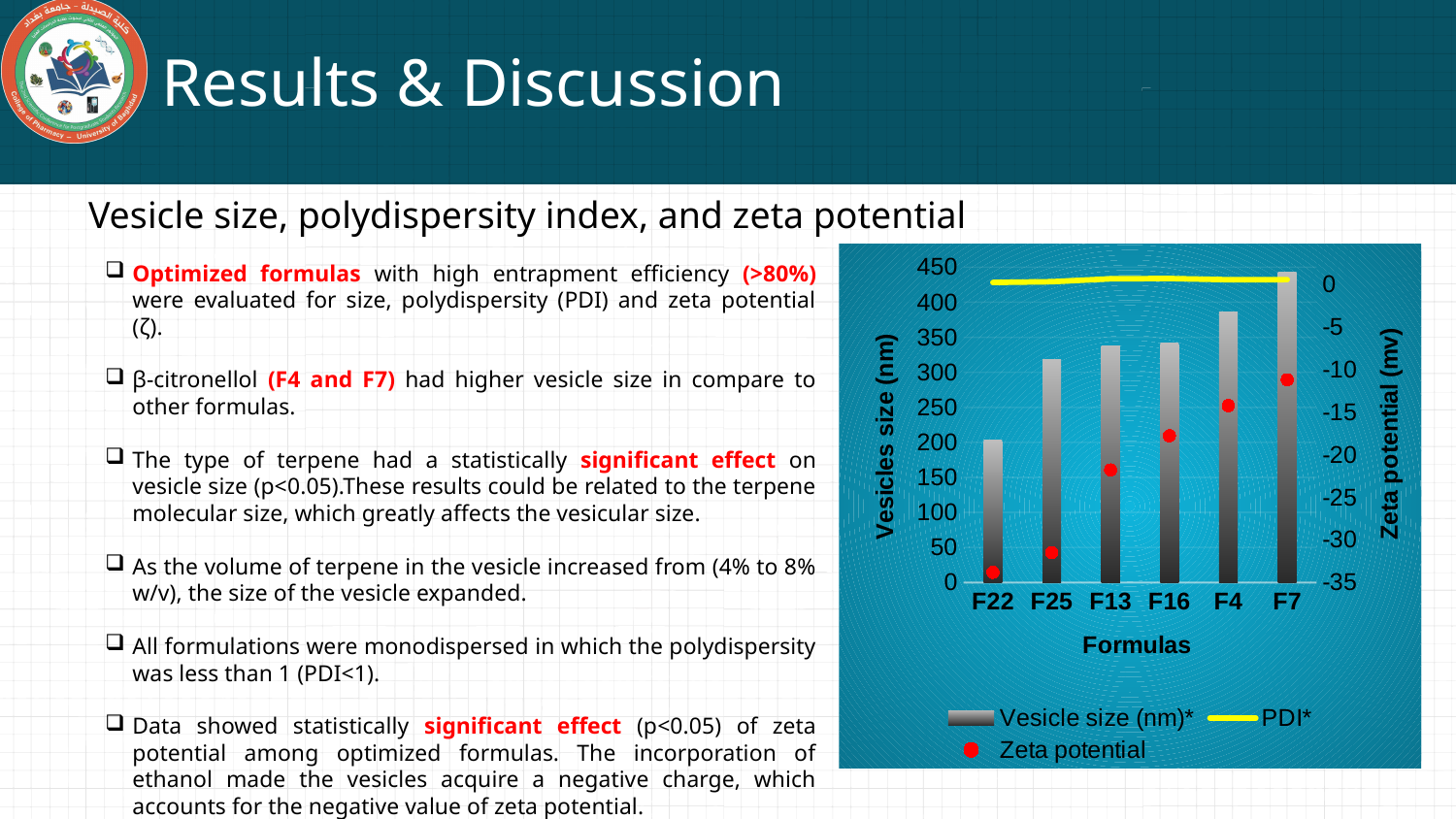
Is the vesicle size for F4 greater or less than 350 nm? greater Which has the larger vesicle size, F25 or F4? F4 Which formula has the lowest vesicle size bar? F22 What is the title of the left vertical axis of the chart? Vesicles size (nm) Is the vesicle size for F13 greater or less than 300 nm? greater Is the vesicle size for F7 greater or less than 400 nm? greater How many formulas are shown on the x axis of the chart? 6 Which formula has the highest vesicle size bar? F7 Which series is drawn as a yellow line in the chart? PDI* How many series does the chart legend list? 3 Do the zeta potential values (red dots) rise or fall from F22 to F7 along the x axis? rise